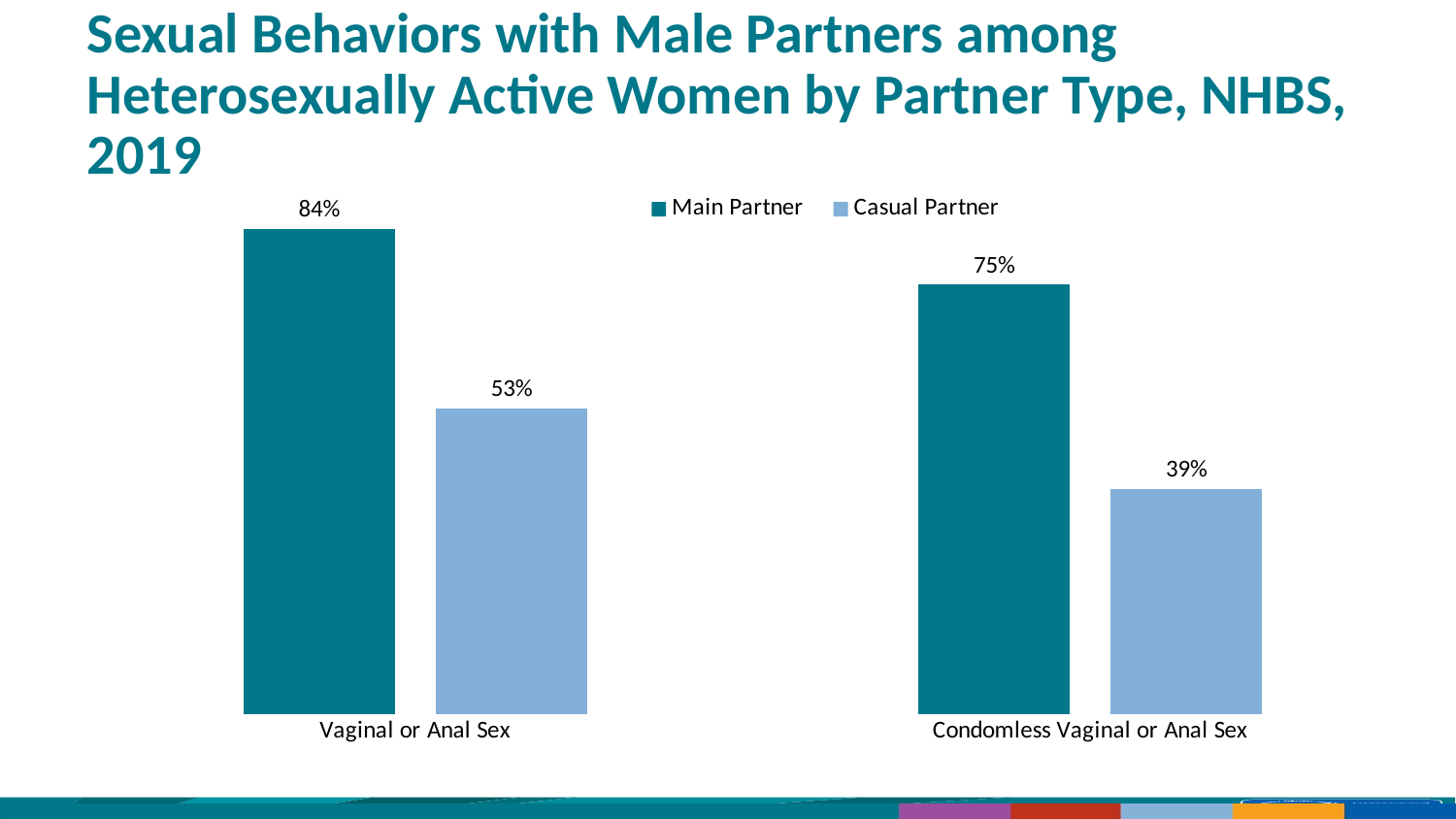
What is the difference in percentage points between main partner and casual partner for vaginal or anal sex? 31 How many series does the legend list? 2 Which bar in the chart has the lowest value? Condomless Vaginal or Anal Sex, Casual Partner What percentage of heterosexually active women reported vaginal or anal sex with a main partner? 84% For condomless vaginal or anal sex, which partner type has the larger value? Main Partner What percentage of heterosexually active women reported condomless vaginal or anal sex with a main partner? 75% How many categories are shown on the x axis? 2 What kind of chart is shown on the slide? Bar chart What percentage of heterosexually active women reported condomless vaginal or anal sex with a casual partner? 39% What percentage of heterosexually active women reported vaginal or anal sex with a casual partner? 53% Which bar in the chart has the highest value? Vaginal or Anal Sex, Main Partner What is the difference in percentage points between main partner and casual partner for condomless vaginal or anal sex? 36